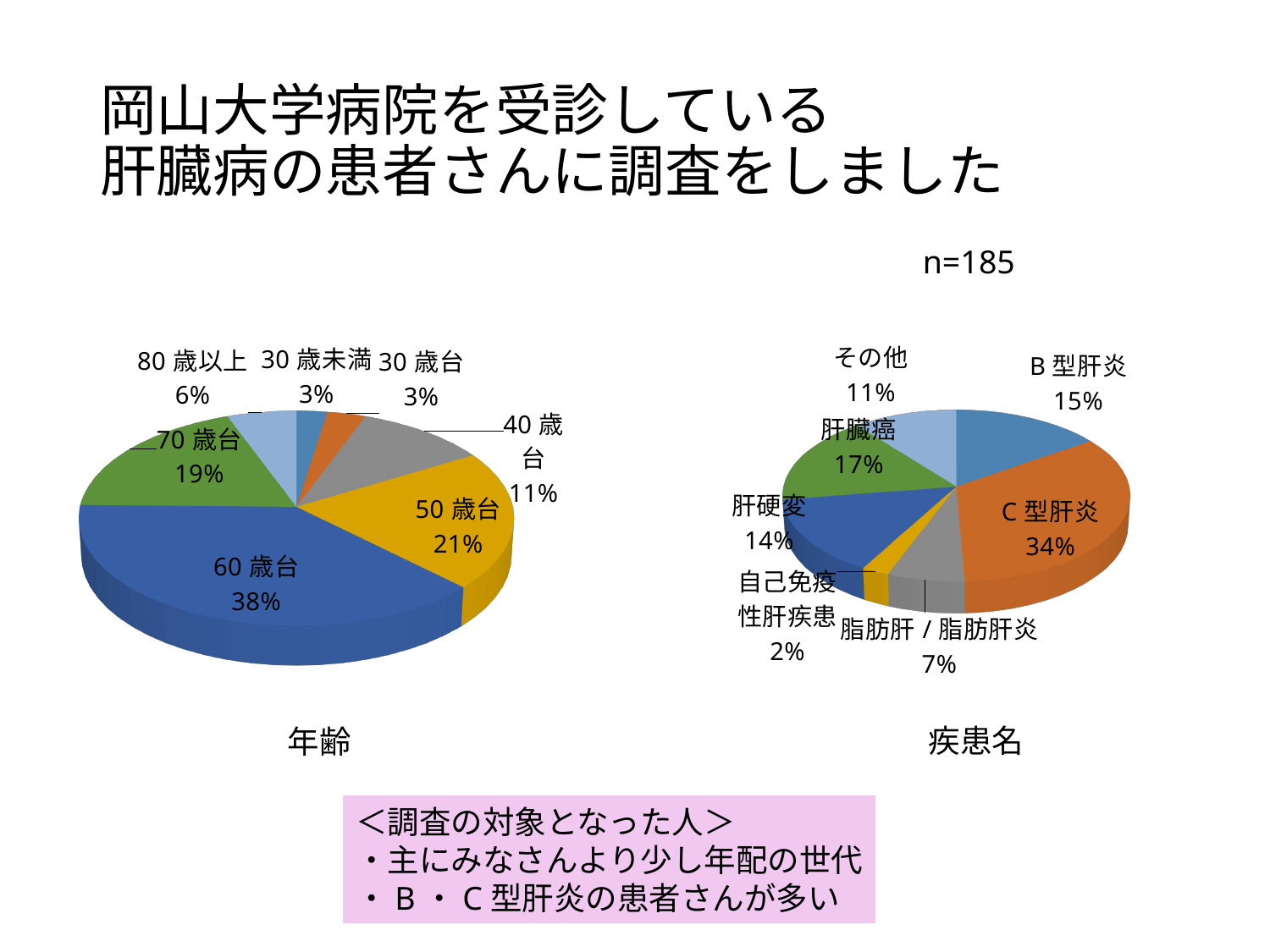
In the 疾患名 pie chart, which disease has the smallest share? 自己免疫性肝疾患 In the 疾患名 pie chart, which is larger, B 型肝炎 or 肝硬変? B 型肝炎 In the 疾患名 pie chart, what is the difference between the shares of C 型肝炎 and B 型肝炎? 19% In the 年齢 pie chart, what share is 50 歳台? 21% In the 年齢 pie chart, how many age categories are shown? 7 What kind of chart is the 疾患名 chart? Pie chart In the 疾患名 pie chart, what share is C 型肝炎? 34% In the 年齢 pie chart, what is the difference between the shares of 70 歳台 and 80 歳以上? 13% In the 年齢 pie chart, what share is 60 歳台? 38% In the 疾患名 pie chart, what share is 肝臓癌? 17% In the 年齢 pie chart, which age group has the largest share? 60 歳台 What sample size (n) is shown on the slide? n=185